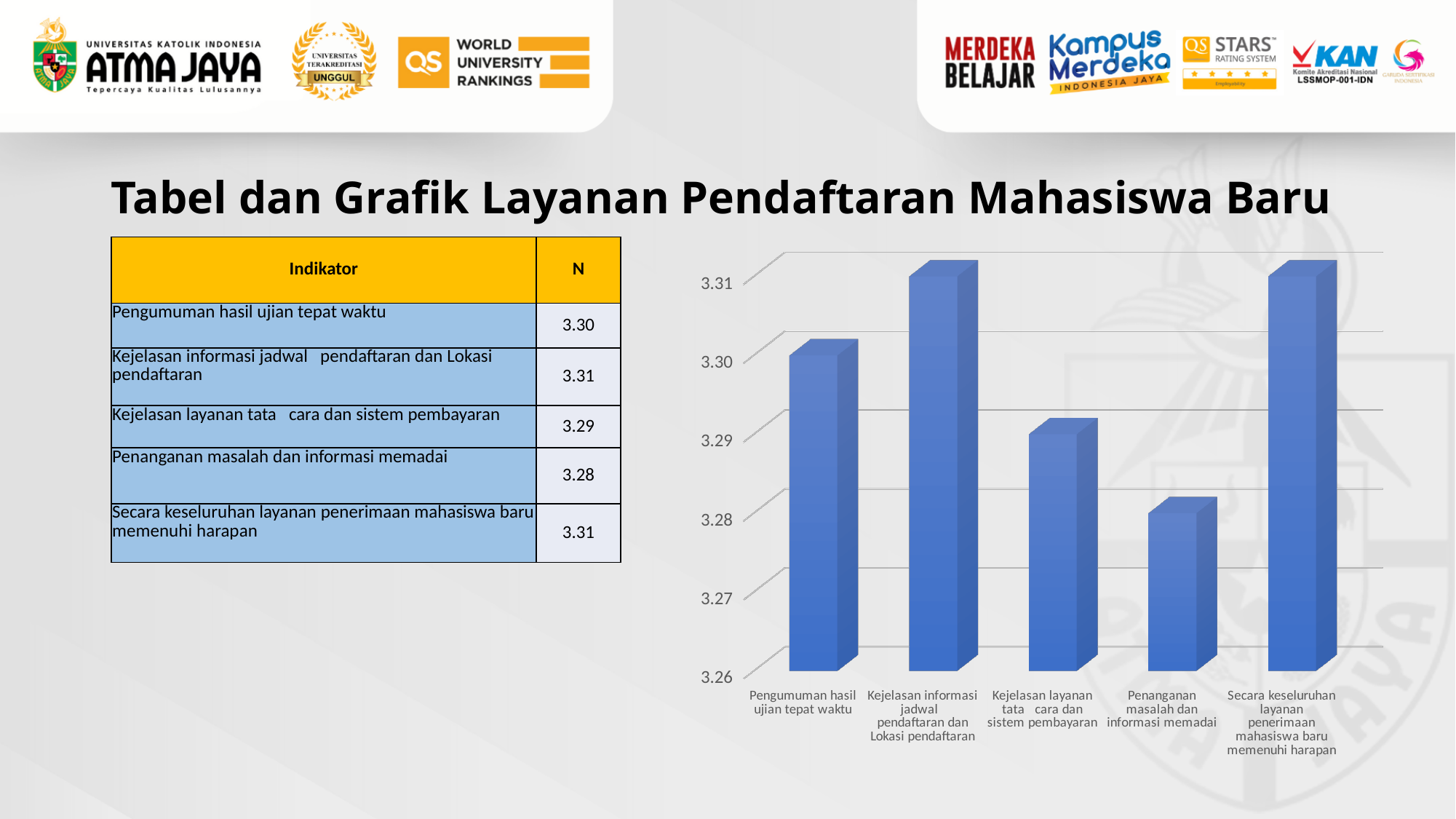
How many indicators (bars) are plotted in the chart? 5 What is the difference between the value for 'Kejelasan informasi jadwal pendaftaran dan Lokasi pendaftaran' and the value for 'Penanganan masalah dan informasi memadai'? 0.03 What is the lowest value labelled on the vertical axis of the chart? 3.26 Which is larger: the value for 'Pengumuman hasil ujian tepat waktu' or for 'Penanganan masalah dan informasi memadai'? Pengumuman hasil ujian tepat waktu What is the value for 'Secara keseluruhan layanan penerimaan mahasiswa baru memenuhi harapan'? 3.31 What is the value for 'Kejelasan layanan tata cara dan sistem pembayaran'? 3.29 Is the value for 'Penanganan masalah dan informasi memadai' greater or less than 3.29? less What is the title of the slide containing the chart? Tabel dan Grafik Layanan Pendaftaran Mahasiswa Baru What is the value for 'Penanganan masalah dan informasi memadai'? 3.28 What is the value for 'Pengumuman hasil ujian tepat waktu'? 3.30 What type of chart is shown on the slide? bar chart Which indicator has the lowest value in the chart? Penanganan masalah dan informasi memadai